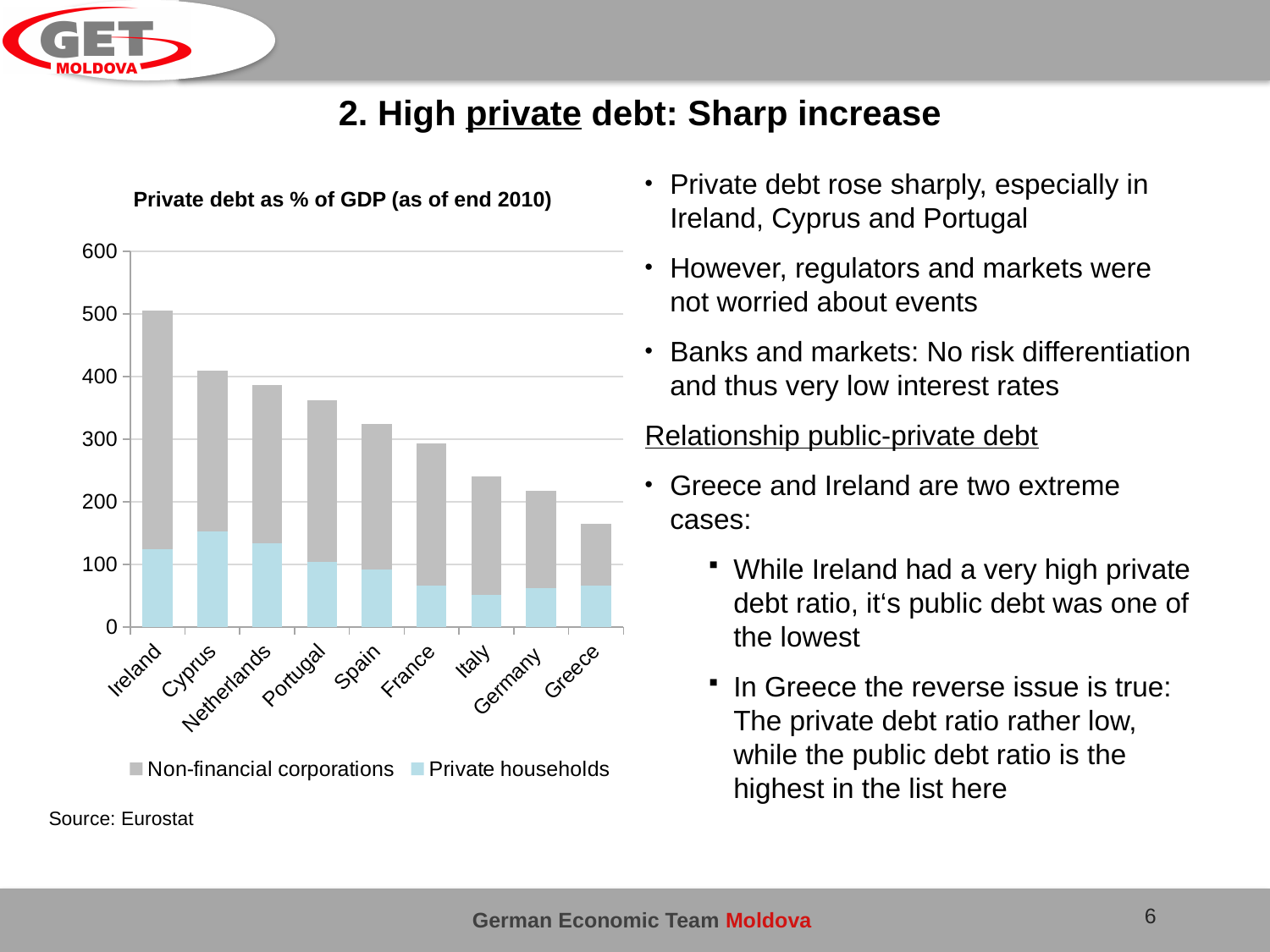
Is the total private debt value for Greece greater or less than 200? less How many series does the chart's legend list? 2 Which country has the larger Private households value, Cyprus or Ireland? Cyprus Which country has the lowest total private debt as % of GDP in the chart? Greece Is the total private debt value for Ireland greater or less than 400? greater Do the total bar heights rise or fall moving from Ireland to Greece along the x axis? Fall Is the total private debt value for Portugal greater or less than 300? greater What is the title of the chart? Private debt as % of GDP (as of end 2010) What kind of chart is shown on the slide? Stacked bar chart How many countries are shown on the x axis of the chart? 9 Which country has the highest total private debt as % of GDP in the chart? Ireland